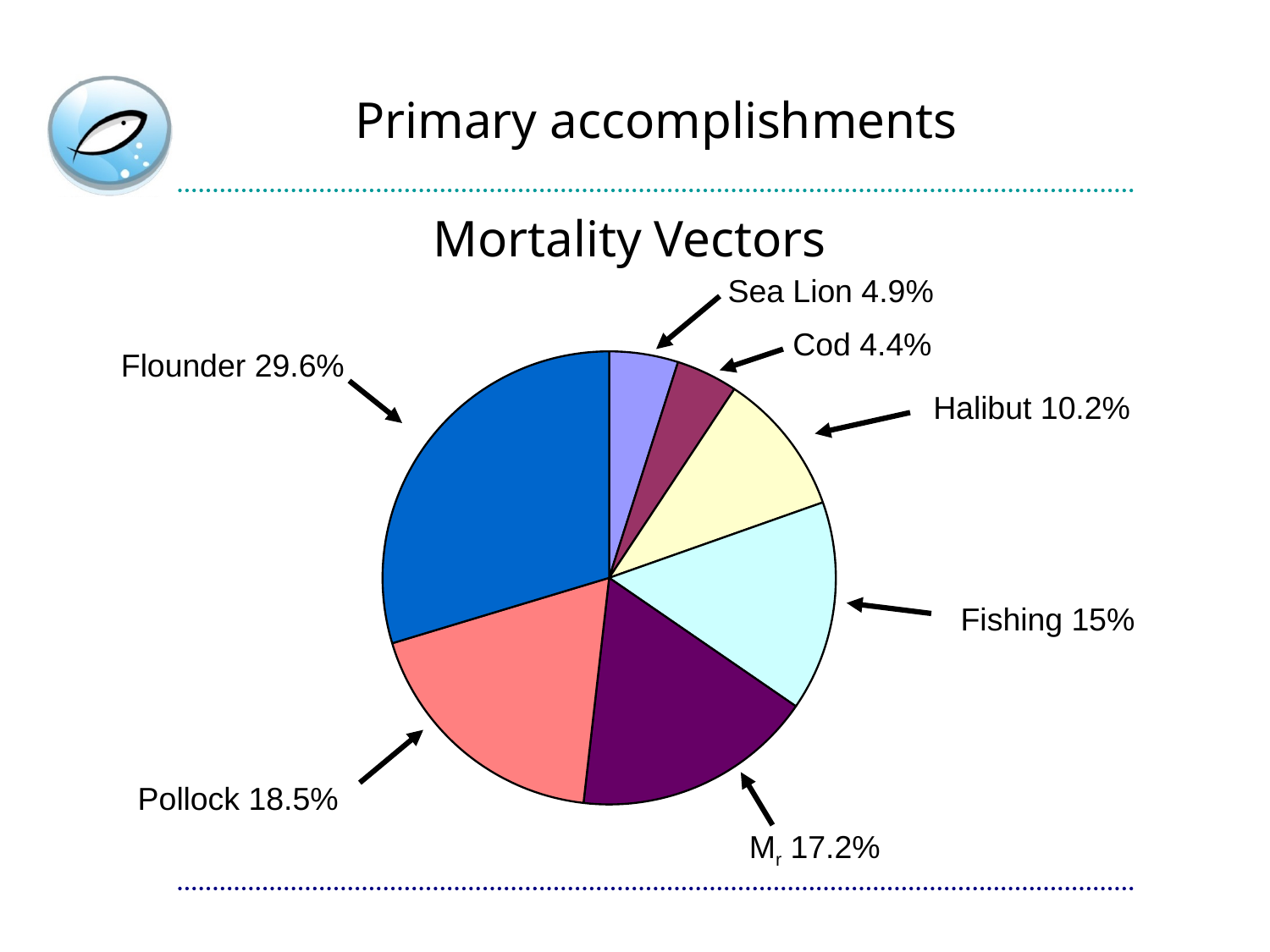
What is the difference between the Fishing and Halibut shares? 4.8% What share of the pie does Flounder account for? 29.6% What is the title of the chart? Mortality Vectors How many categories are shown in the pie chart? 7 What is the value shown for Fishing? 15% Which category has the smallest slice of the pie? Cod What kind of chart is shown on the slide? Pie chart What is the difference between the Flounder and Pollock shares? 11.1% Which is larger, the Sea Lion slice or the Cod slice? Sea Lion What is the value shown for Pollock? 18.5% What is the value shown for Halibut? 10.2% Which category has the largest slice of the pie? Flounder